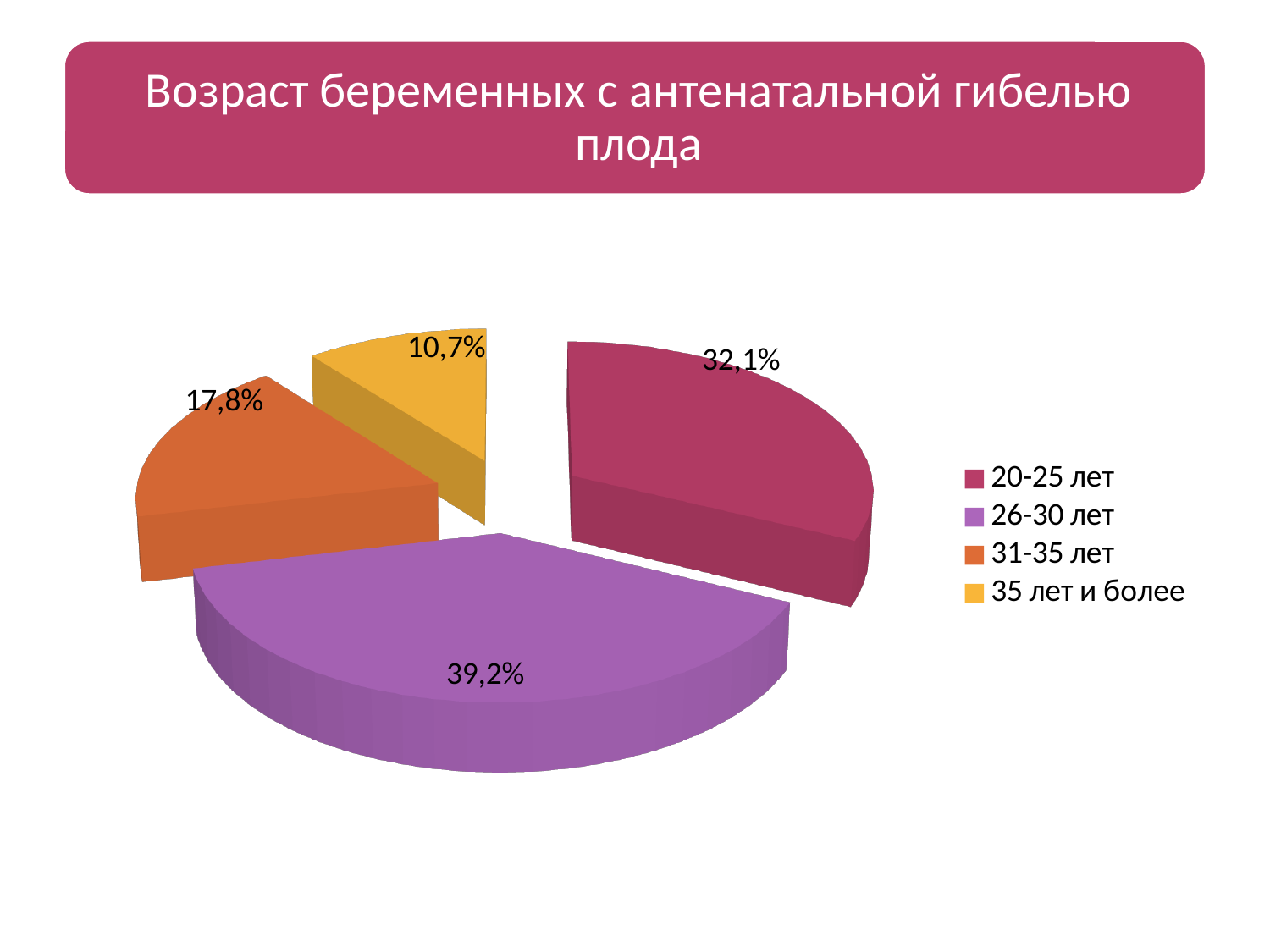
How many categories does the pie chart show? 4 What is the difference between the shares of the 31-35 лет and 35 лет и более groups? 7,1% What share of the pie does the 20-25 лет category have? 32,1% What is the difference between the shares of the 26-30 лет and 20-25 лет groups? 7,1% Which is larger, the share for 20-25 лет or the share for 31-35 лет? 20-25 лет What share of the pie does the 31-35 лет category have? 17,8% Which age group has the largest share of the pie? 26-30 лет What share of the pie does the 35 лет и более category have? 10,7% What share of the pie does the 26-30 лет category have? 39,2% Which age group has the smallest share of the pie? 35 лет и более What is the title of the chart on the slide? Возраст беременных с антенатальной гибелью плода What kind of chart is shown on the slide? Pie chart